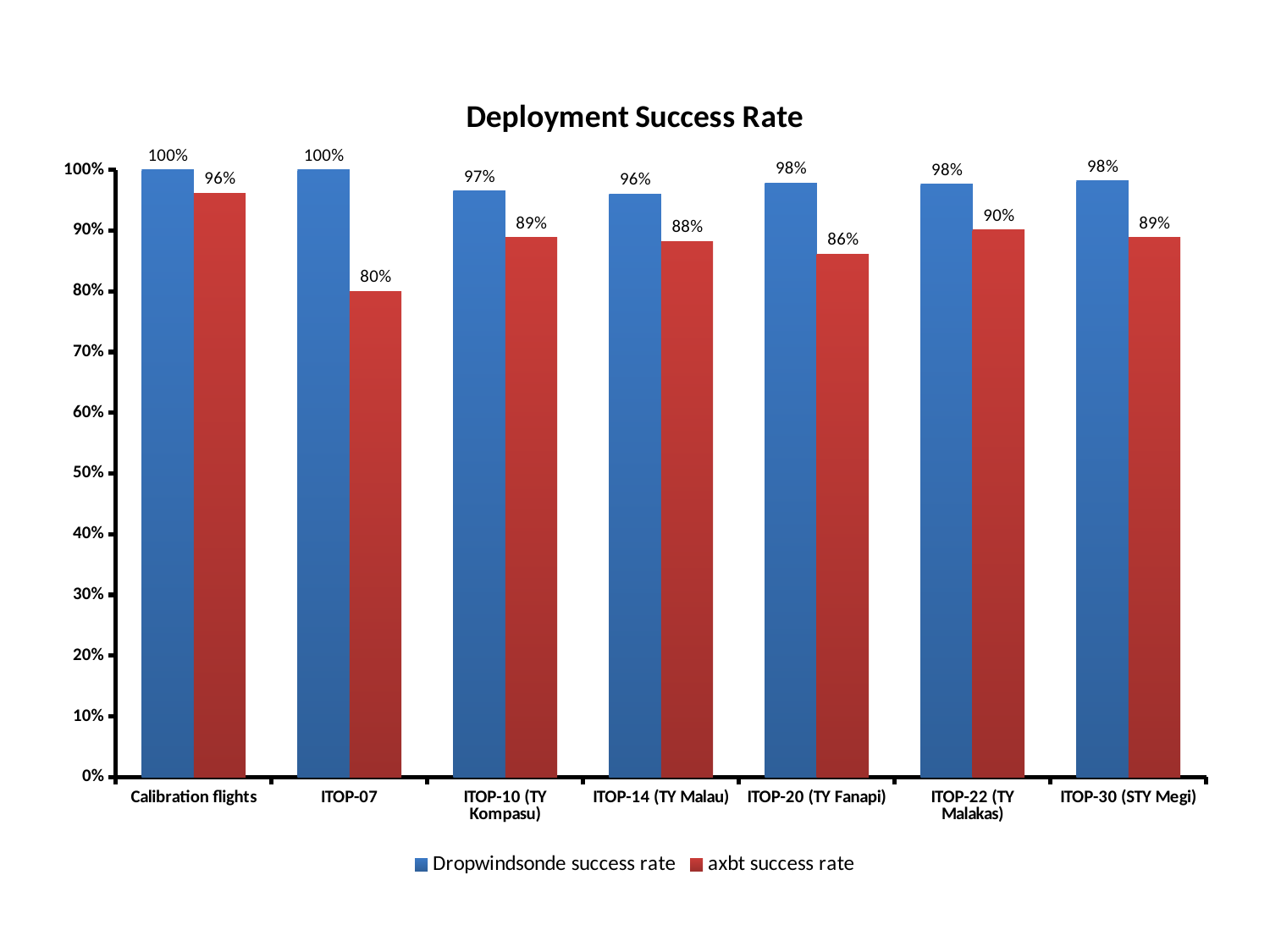
What is the axbt success rate for ITOP-22 (TY Malakas)? 90% Is the axbt success rate for ITOP-20 (TY Fanapi) greater or less than 90%? less How many categories are shown on the x axis? 7 What is the Dropwindsonde success rate for ITOP-10 (TY Kompasu)? 97% How many series does the legend list? 2 Which category has the highest axbt success rate? Calibration flights Which category has the lowest axbt success rate? ITOP-07 What is the difference between the Dropwindsonde success rate and the axbt success rate for ITOP-07? 20% What type of chart is shown on the slide? bar chart Which is larger, the axbt success rate for ITOP-14 (TY Malau) or for ITOP-30 (STY Megi)? ITOP-30 (STY Megi) What is the difference between the axbt success rates for ITOP-22 (TY Malakas) and ITOP-20 (TY Fanapi)? 4% What is the axbt success rate for ITOP-07? 80%